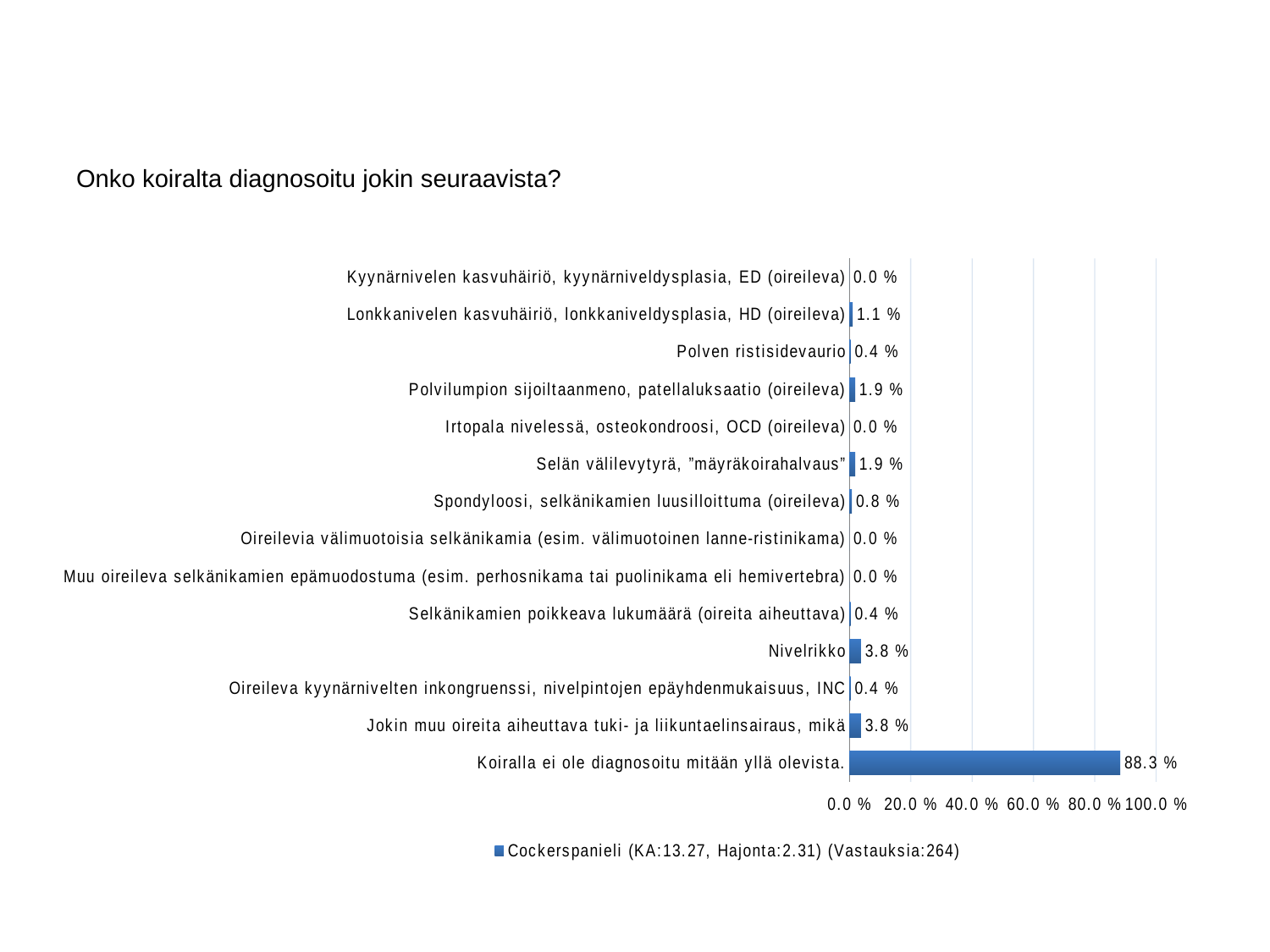
What is the value for "Spondyloosi, selkänikamien luusilloittuma (oireileva)"? 0.8 % What is the difference between the values for "Koiralla ei ole diagnosoitu mitään yllä olevista." and "Nivelrikko"? 84.5 % What is the value for "Nivelrikko"? 3.8 % What kind of chart is shown on the slide? bar chart Is the value for "Koiralla ei ole diagnosoitu mitään yllä olevista." greater or less than 80.0 %? greater What is the title of the chart? Onko koiralta diagnosoitu jokin seuraavista? How many categories are shown in the chart? 14 What is the value for "Lonkkanivelen kasvuhäiriö, lonkkaniveldysplasia, HD (oireileva)"? 1.1 % Which category has the highest value? Koiralla ei ole diagnosoitu mitään yllä olevista. How many series does the legend list? 1 What is the value for "Koiralla ei ole diagnosoitu mitään yllä olevista."? 88.3 % Which is larger, the value for "Polvilumpion sijoiltaanmeno, patellaluksaatio (oireileva)" or the value for "Polven ristisidevaurio"? Polvilumpion sijoiltaanmeno, patellaluksaatio (oireileva)